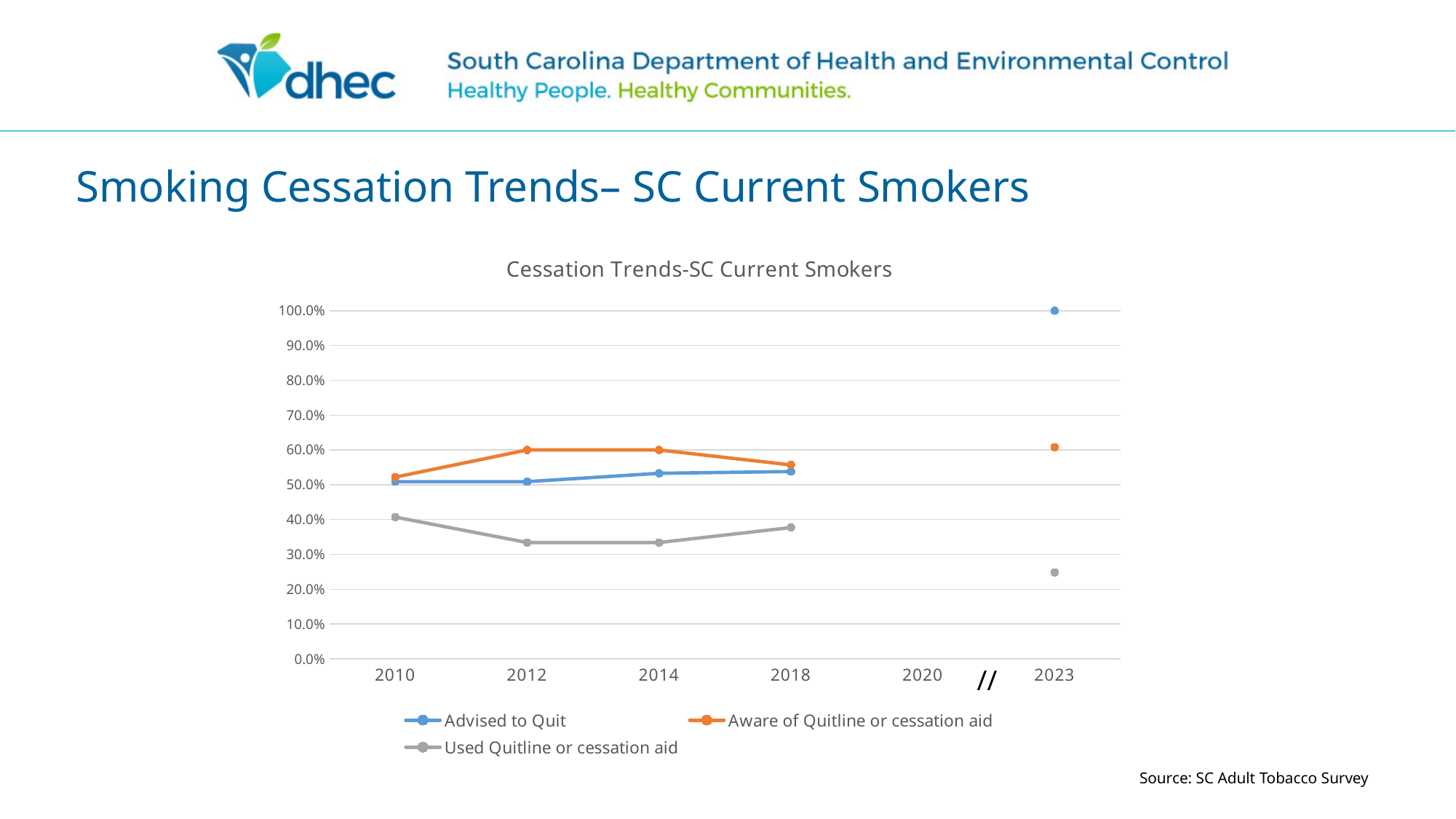
What is the value for Advised to Quit in 2023? 100.0% Is the value for Advised to Quit in 2010 greater or less than 60.0%? less Which series has the highest value in 2023? Advised to Quit What is the value for Aware of Quitline or cessation aid in 2012? 60.0% Does the Used Quitline or cessation aid series rise or fall from 2010 to 2014? fall Which series has the lowest value in 2018? Used Quitline or cessation aid What is the title of the chart? Cessation Trends-SC Current Smokers How many series does the chart legend list? 3 What kind of chart is shown on the slide? line chart In 2018, which is larger: Aware of Quitline or cessation aid or Advised to Quit? Aware of Quitline or cessation aid How many years are labelled on the x axis of the chart? 6 Is the value for Used Quitline or cessation aid in 2023 greater or less than 30.0%? less